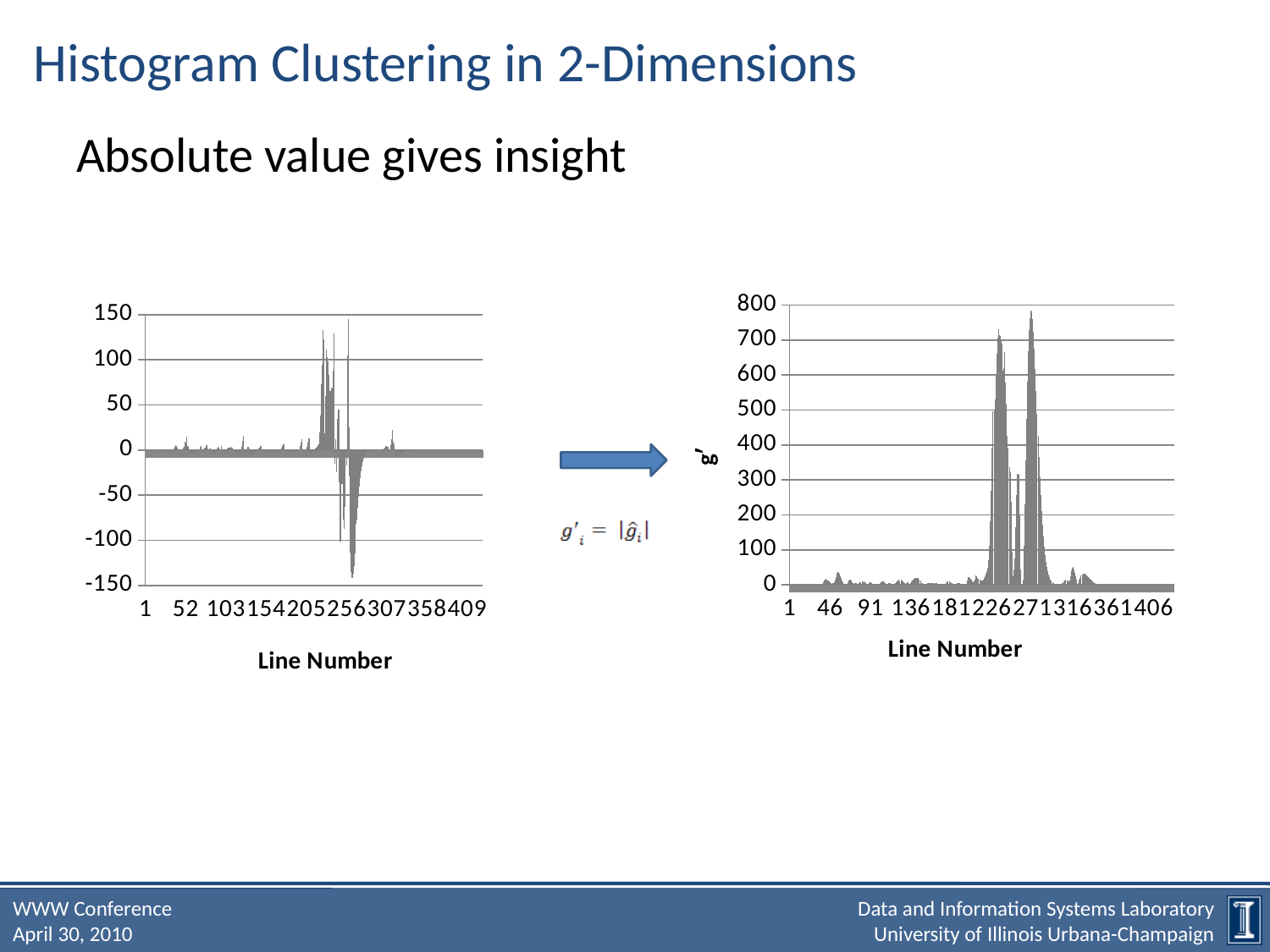
What is the y-axis title of the right chart? g' What is the maximum value shown on the y-axis of the right chart? 800 On the right chart, is the highest peak greater or less than 700? greater What is the last x-axis tick label on the left chart? 409 What is the x-axis title of the left chart? Line Number What is the last x-axis tick label on the right chart? 406 On the left chart, is the lowest negative value greater or less than -100? less On the left chart, is the highest positive peak greater or less than 100? greater What is the minimum value shown on the y-axis of the left chart? -150 How many tick labels are shown on the x-axis of the left chart? 9 How many tick labels are shown on the x-axis of the right chart? 10